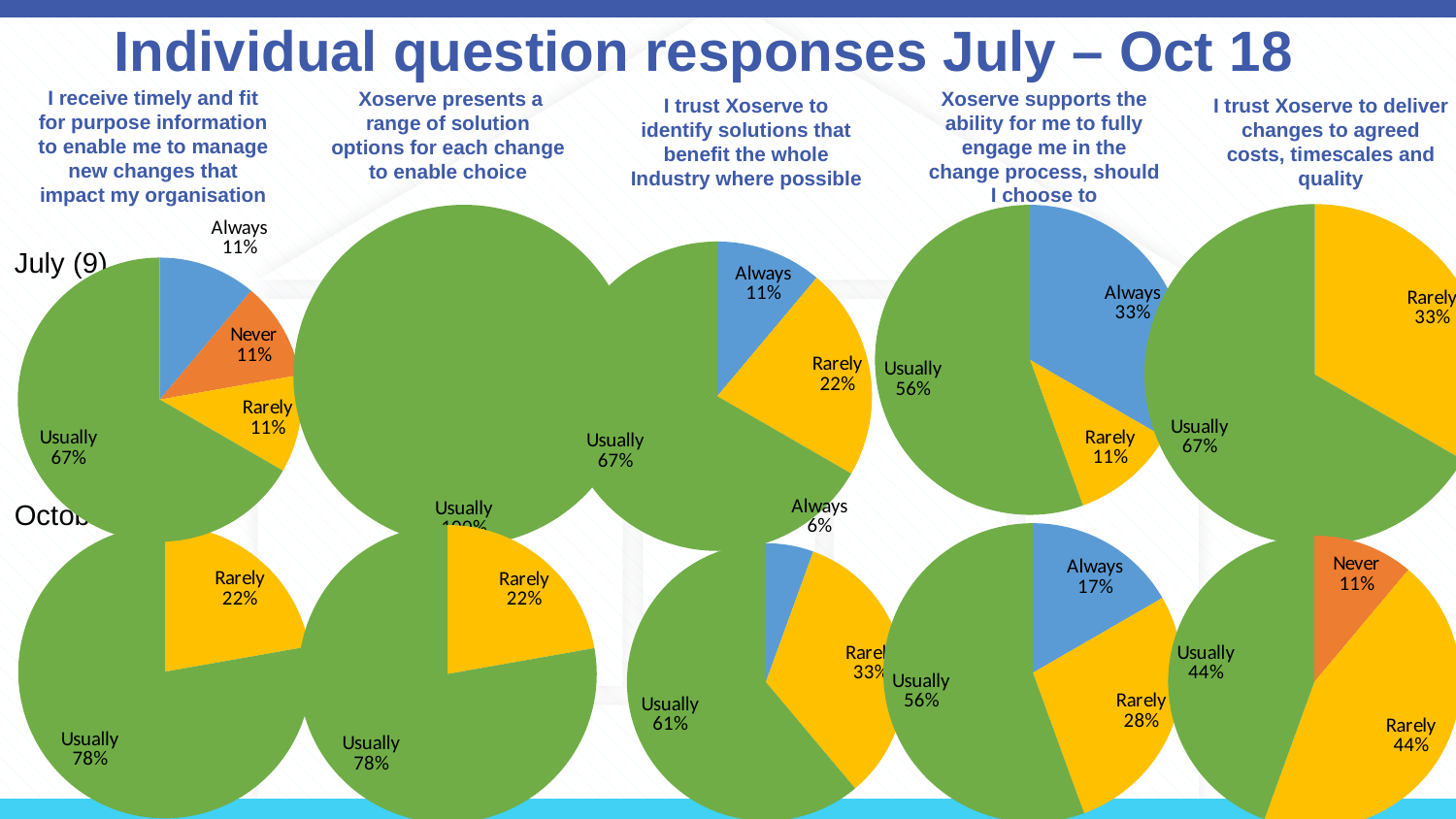
How many slices does the July pie chart for "I receive timely and fit for purpose information to enable me to manage new changes that impact my organisation" have? 4 In the October pie chart for "I trust Xoserve to identify solutions that benefit the whole Industry where possible", which is larger, Usually or Rarely? Usually In the October pie chart for "I trust Xoserve to identify solutions that benefit the whole Industry where possible", what share is Always? 6% In the July pie chart for "I trust Xoserve to deliver changes to agreed costs, timescales and quality", what is the difference between the Usually and Rarely shares? 34% In the July pie chart for "Xoserve supports the ability for me to fully engage me in the change process, should I choose to", which response has the largest share? Usually In the July pie chart for "I trust Xoserve to identify solutions that benefit the whole Industry where possible", what share is Rarely? 22% In the July pie chart for "I receive timely and fit for purpose information to enable me to manage new changes that impact my organisation", what share is Never? 11% In the October pie chart for "I trust Xoserve to deliver changes to agreed costs, timescales and quality", what share is Never? 11% In the October pie chart for "Xoserve supports the ability for me to fully engage me in the change process, should I choose to", what share is Rarely? 28% In the July pie chart for "I receive timely and fit for purpose information to enable me to manage new changes that impact my organisation", what share is Usually? 67% What type of chart is used on this slide to show the question responses? Pie chart In the October pie chart for "I receive timely and fit for purpose information to enable me to manage new changes that impact my organisation", what share is Usually? 78%